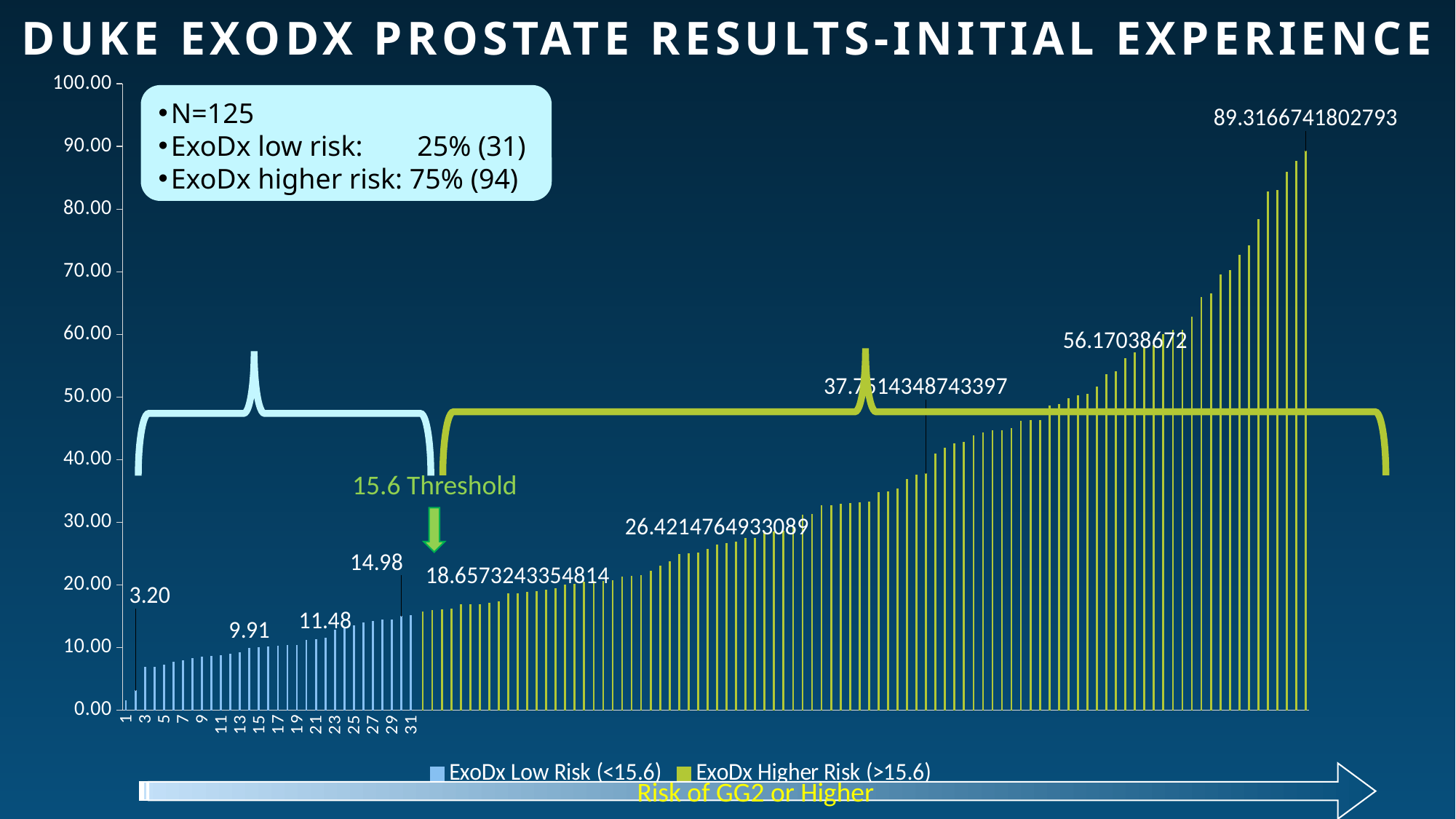
What is the title of the slide containing the chart? DUKE EXODX PROSTATE RESULTS-INITIAL EXPERIENCE Is the value of the bar at category 31 greater or less than 20? less What is the lowest data label printed on the chart? 3.20 How many series does the chart legend list? 2 What is the highest data label printed on the chart? 89.3166741802793 What are the two series named in the chart legend? ExoDx Low Risk (<15.6) and ExoDx Higher Risk (>15.6) Which labeled value is larger, 56.17038672 or 26.4214764933089? 56.17038672 Which series contains the tallest bar on the chart? ExoDx Higher Risk (>15.6) What is the difference between the labeled values 11.48 and 9.91? 1.57 Do the bar values rise or fall moving from left to right along the x axis? rise What is the difference between the labeled values 14.98 and 3.20? 11.78 What kind of chart is shown on the slide? bar chart